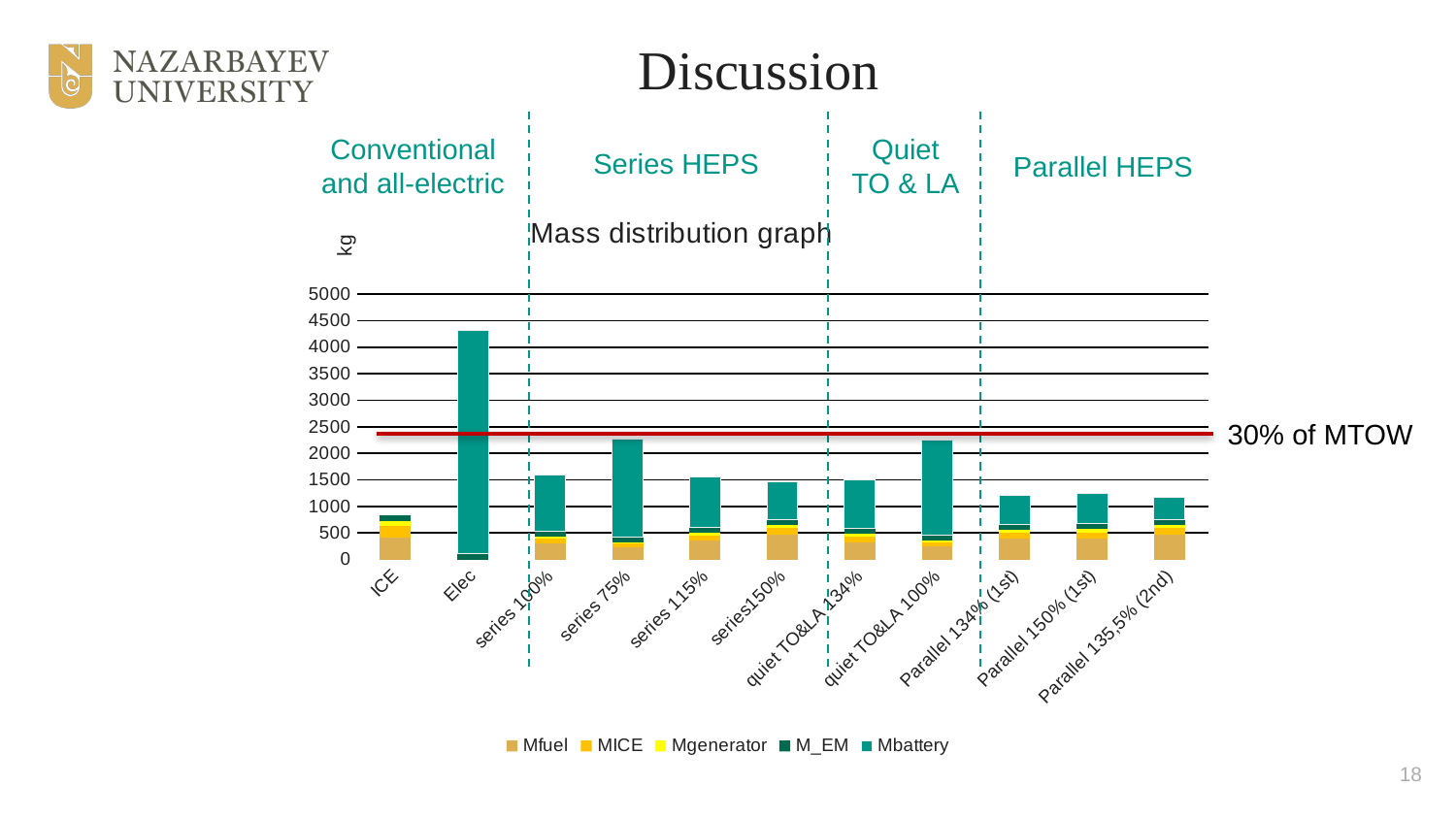
Is the total value for Elec greater or less than 4000? greater What unit is shown on the y axis of the Mass distribution graph? kg Which category has the shortest total bar in the Mass distribution graph? ICE Is the total value for Parallel 150% (1st) greater or less than 1500? less Is the total value for series 75% greater or less than 2500? less Which category has the tallest total bar in the Mass distribution graph? Elec How many series does the legend of the Mass distribution graph list? 5 Which has the larger total bar, Elec or series 75%? Elec What does the red horizontal line on the chart represent? 30% of MTOW How many categories are shown on the x axis of the Mass distribution graph? 11 What kind of chart is the Mass distribution graph? stacked bar chart